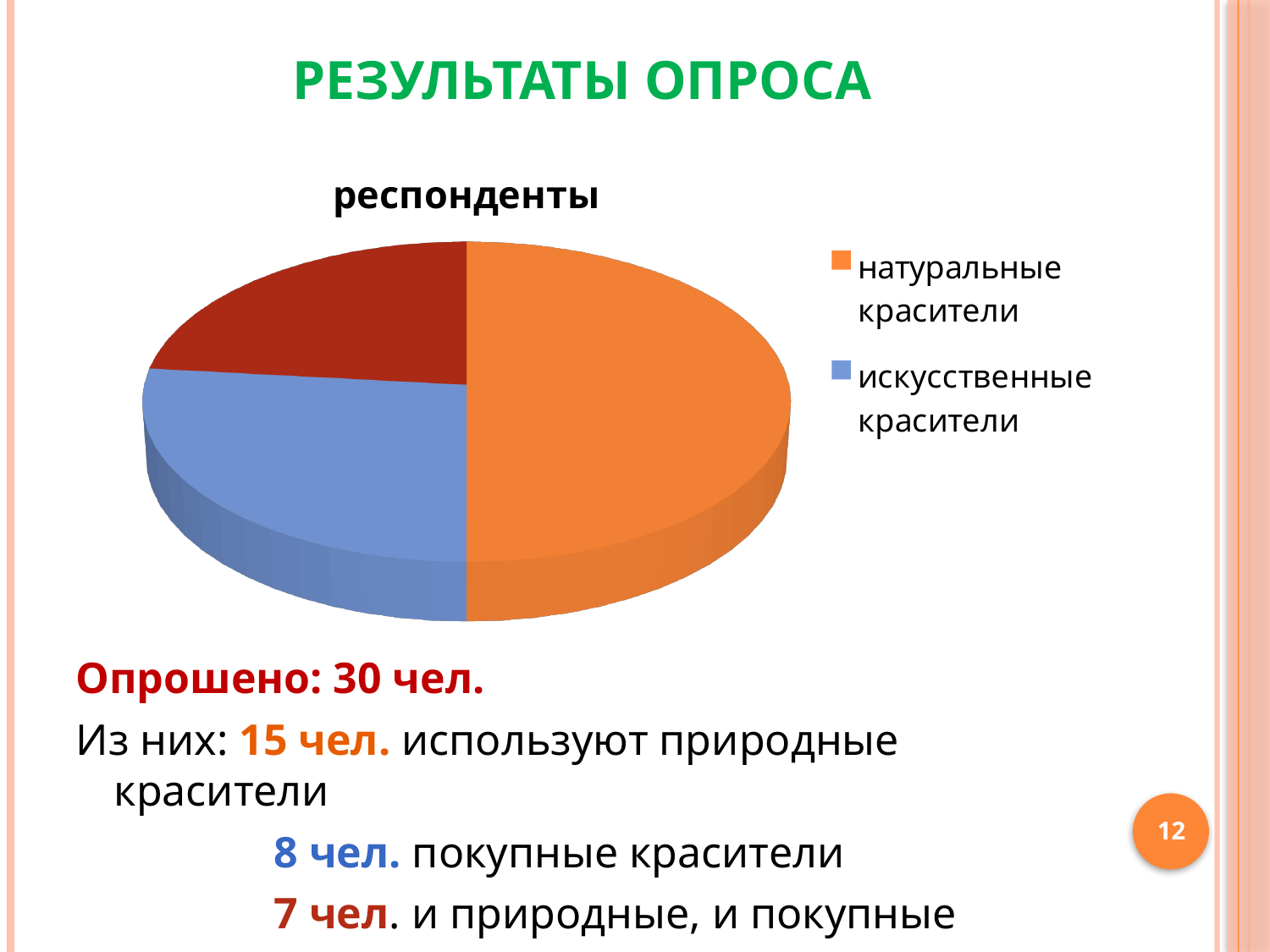
What kind of chart is shown on the slide? pie chart According to the slide, how many people were surveyed in total? 30 чел. How many entries does the legend of the pie chart list? 2 According to the slide, how many respondents use both natural and purchased dyes? 7 чел. What share of the 30 respondents use natural dyes (15 чел.)? 50% According to the slide, how many respondents use natural (природные) dyes? 15 чел. How many slices does the pie chart have? 3 Which category has the largest slice of the pie chart? натуральные красители What is the title of the pie chart? респонденты Which slice is larger: натуральные красители or искусственные красители? натуральные красители According to the slide, how many respondents use purchased (покупные) dyes? 8 чел. What colour is the slice for натуральные красители? orange